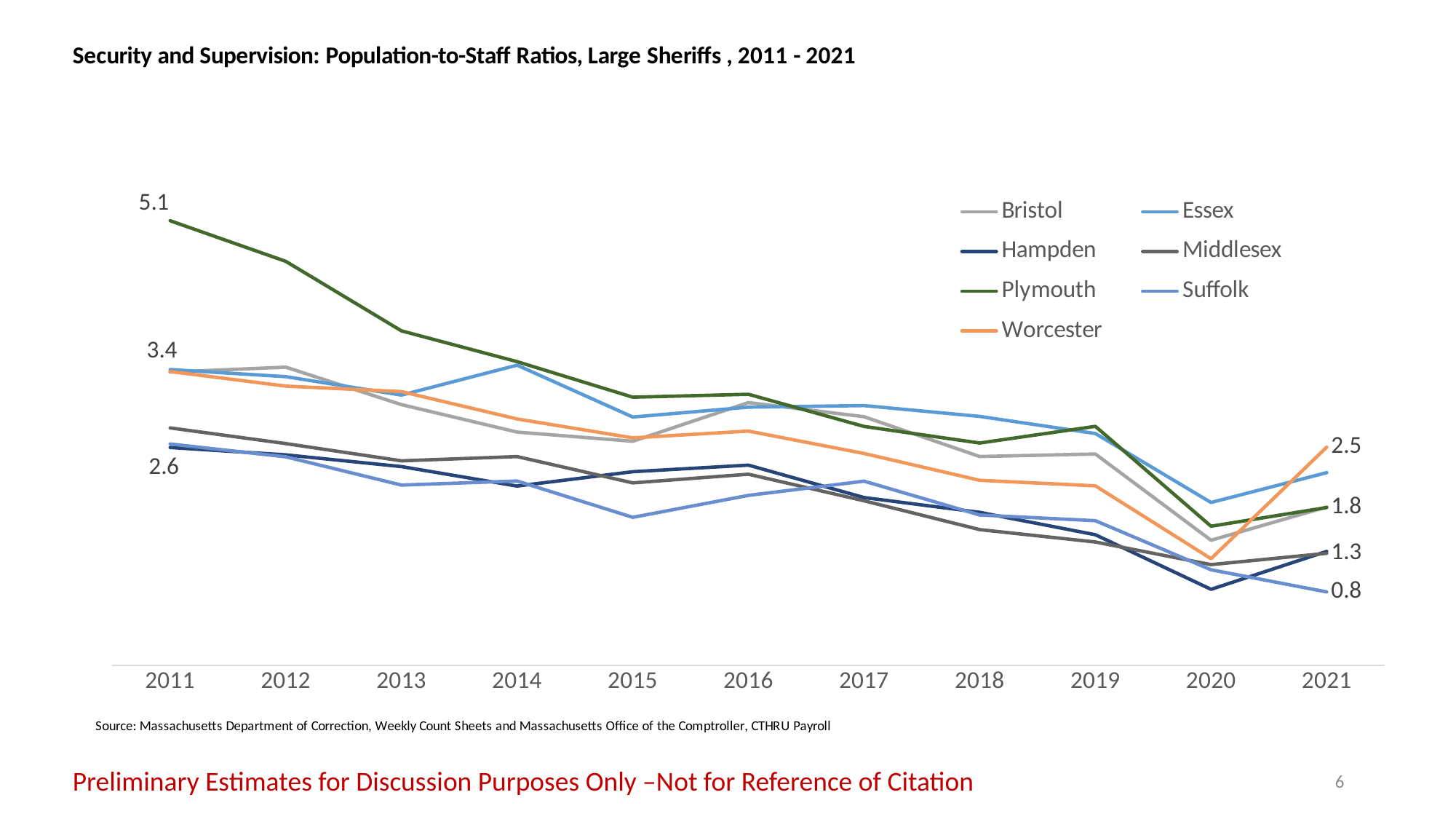
Which sheriff had the highest population-to-staff ratio in 2021? Worcester Does the Plymouth ratio generally rise or fall from 2011 to 2021? fall What is the population-to-staff ratio for Suffolk in 2021? 0.8 What is the population-to-staff ratio for Worcester in 2021? 2.5 How many series does the legend list? 7 How many years are shown on the x axis? 11 What is the difference between the Worcester and Suffolk ratios in 2021? 1.7 Which sheriff had the highest population-to-staff ratio in 2011? Plymouth What is the population-to-staff ratio for Plymouth in 2011? 5.1 What kind of chart is shown on the slide? line chart What colour is the Worcester line in the legend? orange Which sheriff had the lowest population-to-staff ratio in 2021? Suffolk